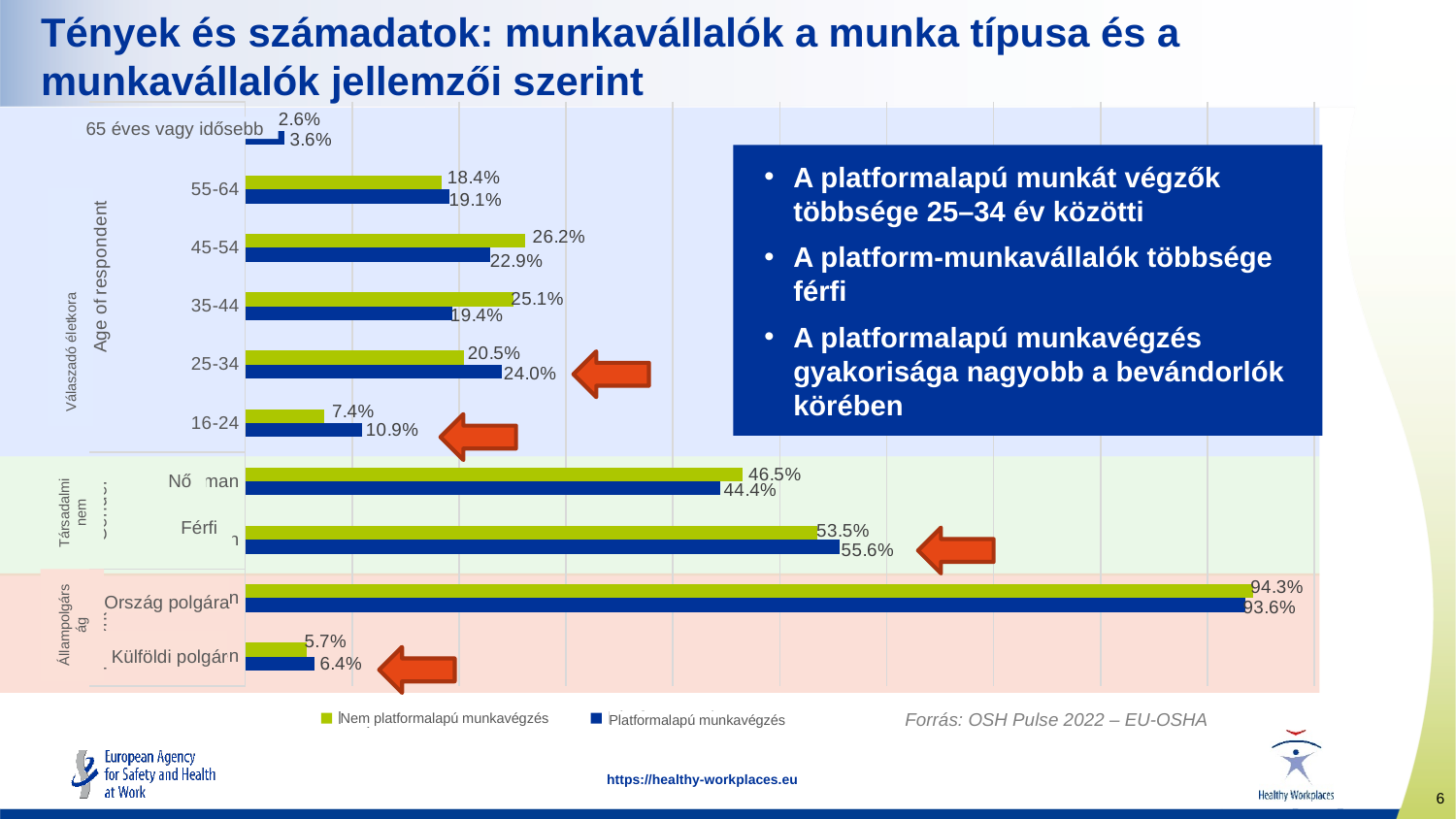
Which series is shown in green in the chart? Nem platformalapú munkavégzés Among the age groups, which has the highest value in the Platformalapú munkavégzés series? 25-34 What is the value for the 25-34 age group in the Platformalapú munkavégzés series? 24.0% What is the difference between the Platformalapú munkavégzés and Nem platformalapú munkavégzés values for Férfi? 2.1% How many series does the legend list? 2 What kind of chart is shown on the slide? Bar chart For the 16-24 age group, which series has the larger value? Platformalapú munkavégzés For the 35-44 age group, which series has the larger value? Nem platformalapú munkavégzés What is the value for the 45-54 age group in the Nem platformalapú munkavégzés series? 26.2% Among the age groups, which has the lowest value in the Nem platformalapú munkavégzés series? 65 éves vagy idősebb How many age-group categories are plotted in the chart? 6 What is the value for Külföldi polgár in the Platformalapú munkavégzés series? 6.4%